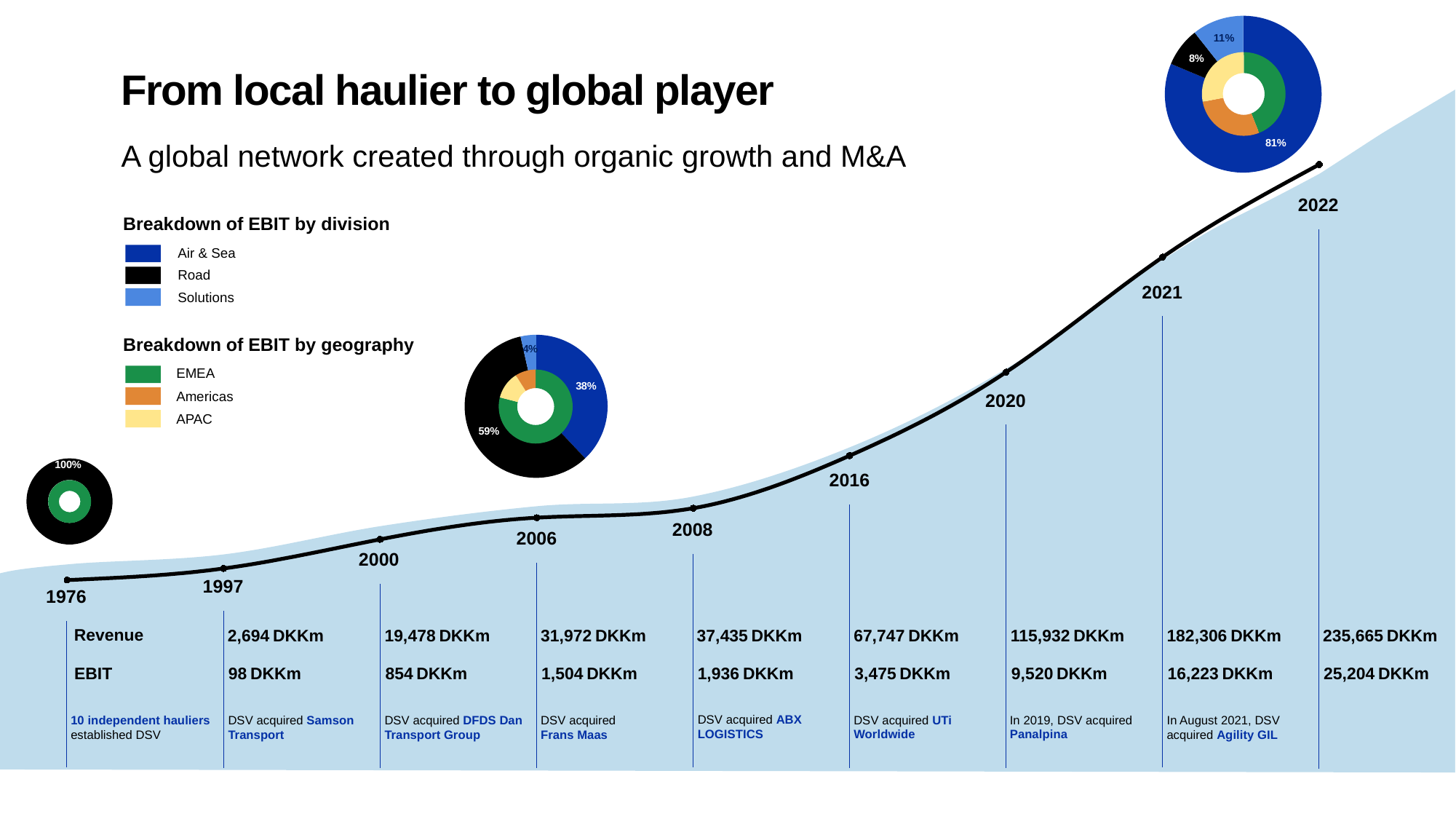
On the timeline chart, what is the difference in revenue between 2020 and 2016? 48,185 DKKm In the 2022 EBIT breakdown donut chart, what share does Air & Sea have? 81% What kind of chart is used to show the breakdown of EBIT by division and geography? donut (pie) chart On the timeline chart, does revenue rise or fall from 1997 to 2022? rise In the 2006 EBIT breakdown donut chart, what share does Road have? 59% On the timeline chart, which year had the larger revenue, 2016 or 2020? 2020 On the timeline chart, what is the difference in EBIT between 2022 and 2021? 8,981 DKKm On the timeline chart, which year has the highest revenue? 2022 How many years are marked on the timeline chart? 9 On the timeline chart, what was the revenue in 2022? 235,665 DKKm How many divisions does the 'Breakdown of EBIT by division' legend list? 3 On the timeline chart, what was the EBIT in 2008? 1,936 DKKm